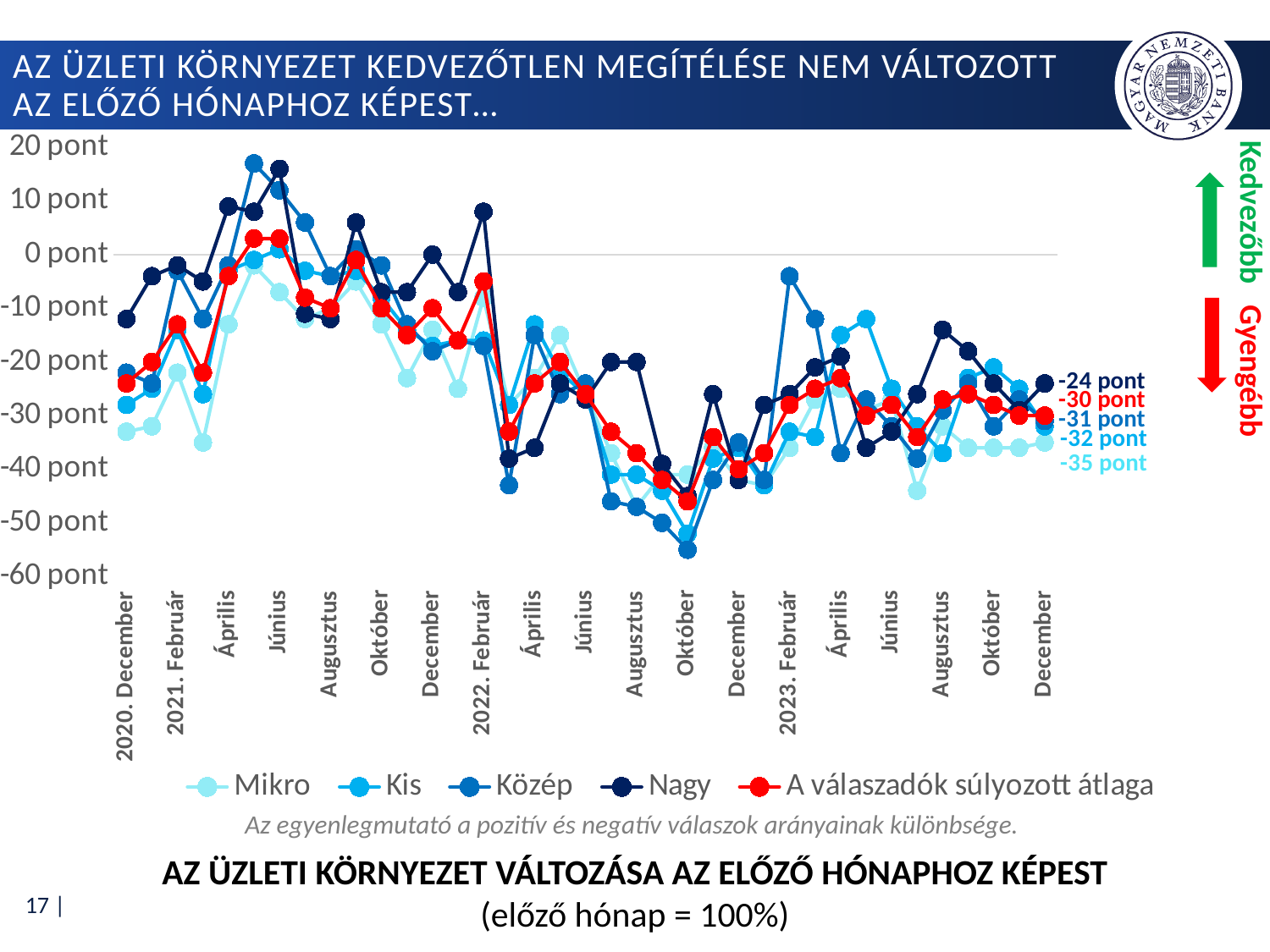
What is the value for Kis at the last point (2023 December)? -32 pont Does the A válaszadók súlyozott átlaga series end higher or lower in 2023 December than it started in 2020 December? lower Which series has the lowest value at the last point (2023 December)? Mikro How many series does the legend list? 5 What kind of chart is shown on the slide? line chart What is the value for A válaszadók súlyozott átlaga at the last point (2023 December)? -30 pont Which series is drawn in red? A válaszadók súlyozott átlaga At the last point (2023 December), is the value for Közép greater or less than -20 pont? less Which series has the highest value at the last point (2023 December)? Nagy What is the value for Nagy at the last point (2023 December)? -24 pont What is the value for Mikro at the last point (2023 December)? -35 pont What is the difference between the Nagy and Mikro values at the last point (2023 December)? 11 pont